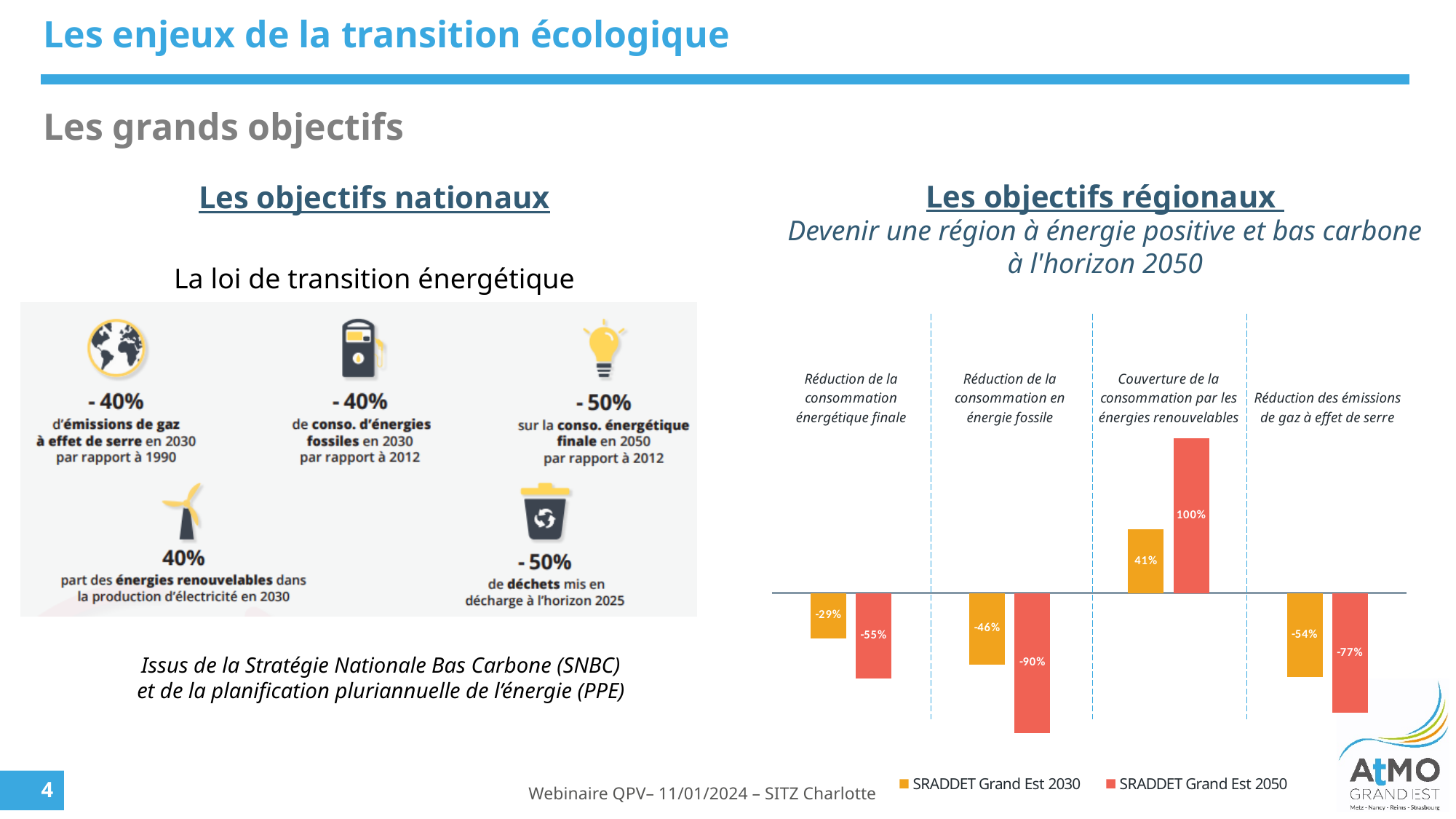
What is the SRADDET Grand Est 2050 value for 'Réduction des émissions de gaz à effet de serre'? -77% What is the SRADDET Grand Est 2030 value for 'Couverture de la consommation par les énergies renouvelables'? 41% What is the SRADDET Grand Est 2030 value for 'Réduction de la consommation énergétique finale'? -29% Which colour represents the SRADDET Grand Est 2050 series in the bar chart? Red Which category has the lowest SRADDET Grand Est 2030 value? Réduction des émissions de gaz à effet de serre How many categories are shown in the bar chart? 4 What is the difference between the SRADDET Grand Est 2050 and 2030 values for 'Couverture de la consommation par les énergies renouvelables'? 59 percentage points Which category has the highest SRADDET Grand Est 2050 value? Couverture de la consommation par les énergies renouvelables How many series does the legend of the bar chart list? 2 What is the SRADDET Grand Est 2050 value for 'Réduction de la consommation en énergie fossile'? -90% For 'Réduction de la consommation en énergie fossile', which series has the larger value: SRADDET Grand Est 2030 or SRADDET Grand Est 2050? SRADDET Grand Est 2030 What kind of chart is shown under 'Les objectifs régionaux'? Bar chart